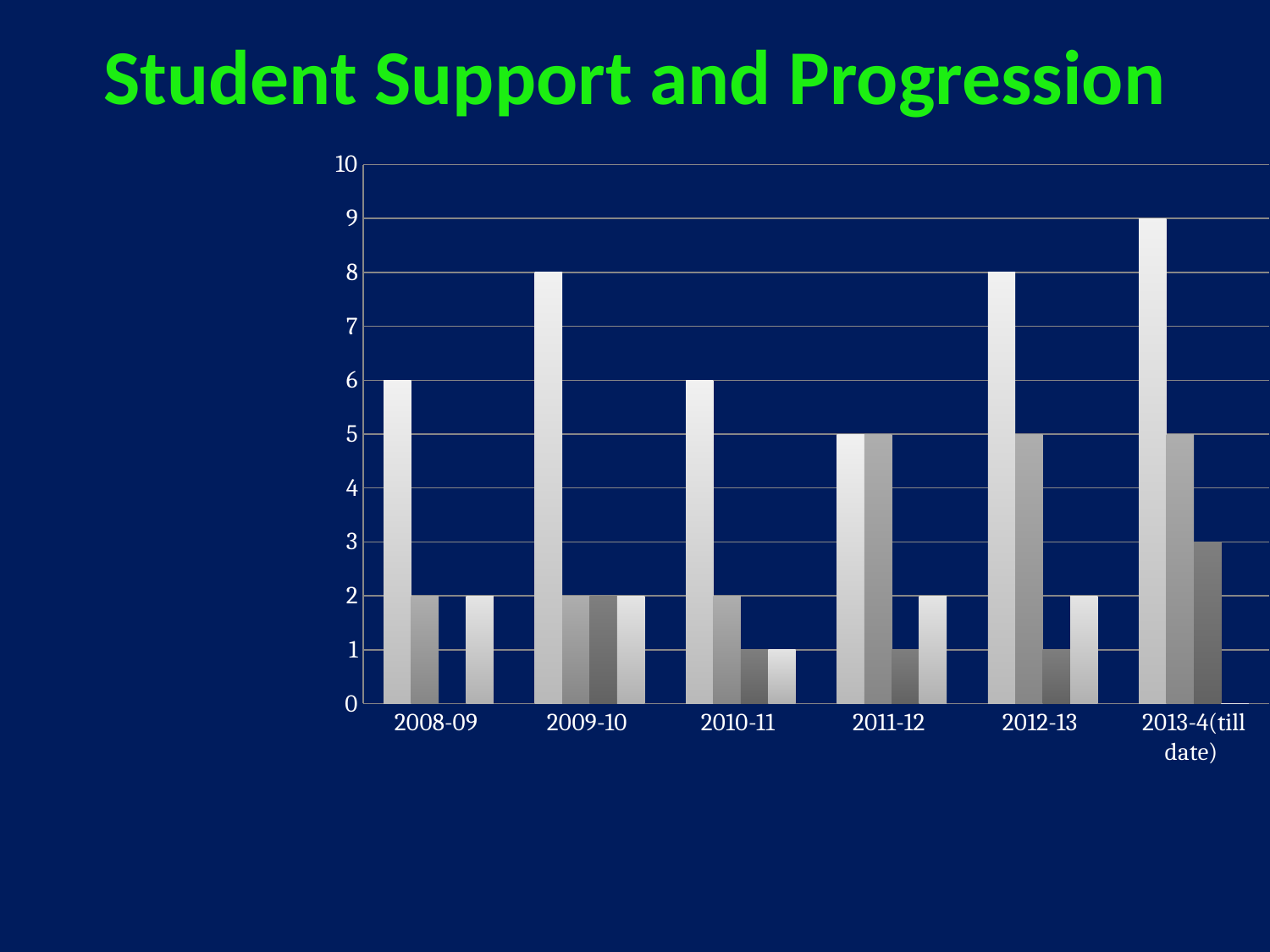
What is the value of the first (leftmost) bar in the 2008-09 group? 6 Which is larger: the first bar for 2009-10 or the first bar for 2010-11? 2009-10 Which year group contains the tallest bar in the chart? 2013-4(till date) What is the value of the tallest bar in the 2013-4(till date) group? 9 How many year categories are shown on the x axis? 6 What is the highest value shown on the y axis? 10 What is the value of the tallest bar in the 2009-10 group? 8 What type of chart is shown on the slide? bar chart What is the value of the second bar in the 2012-13 group? 5 What is the difference between the tallest bar in 2013-4(till date) and the tallest bar in 2012-13? 1 Is the value of the tallest bar in the 2011-12 group greater or less than 7? less What is the title of the slide containing the chart? Student Support and Progression